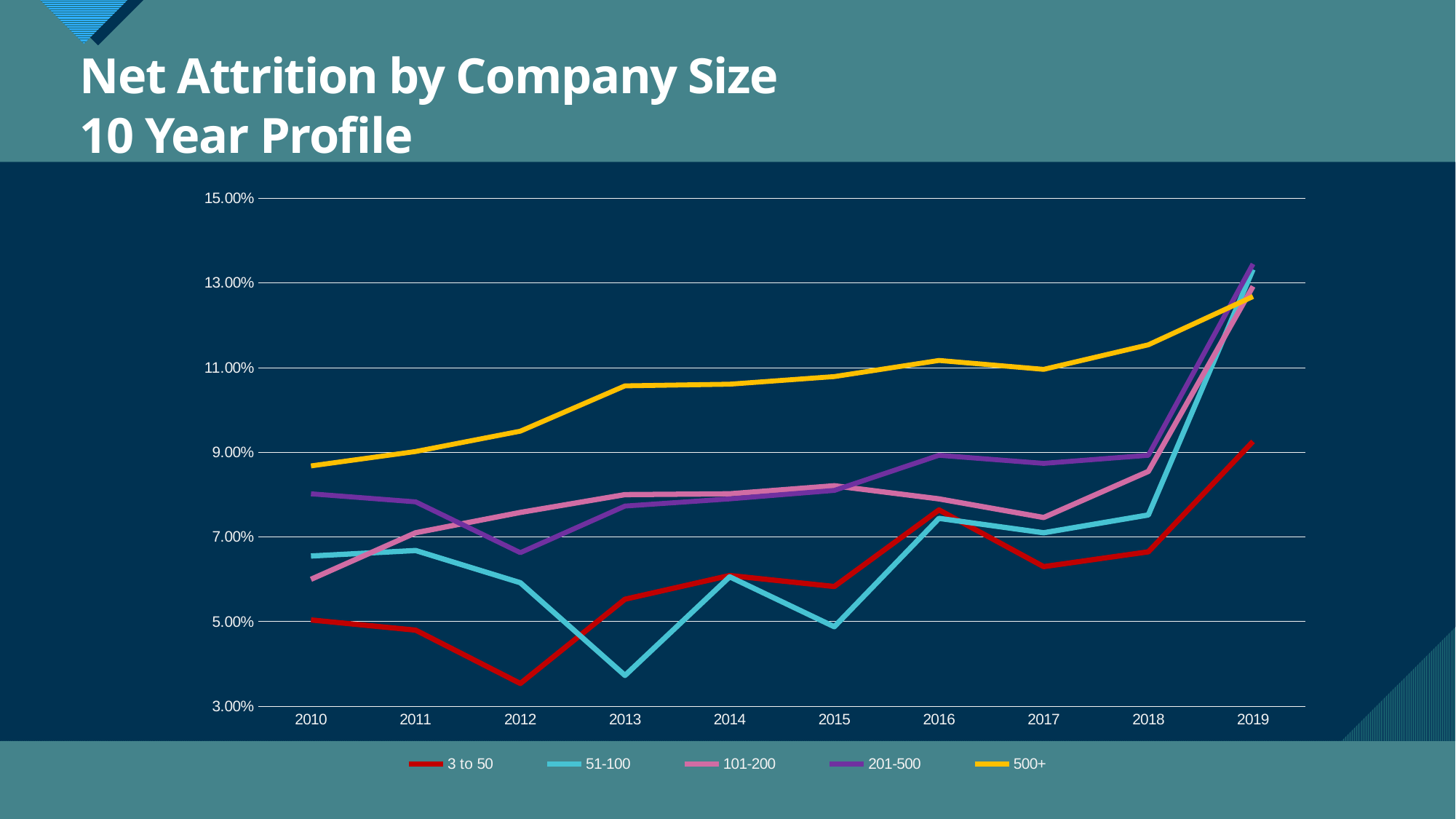
How many series does the legend list? 5 Is the value for 201-500 in 2019 greater or less than 13.00%? greater Is the value for 3 to 50 in 2012 greater or less than 5.00%? less Does the 500+ series generally rise or fall from 2010 to 2019? rise Which company size series has the lowest value in 2019? 3 to 50 Is the value for 500+ in 2010 greater or less than 9.00%? less Which company size series has the lowest value in 2013? 51-100 In 2012, which is larger: the value for 3 to 50 or the value for 51-100? 51-100 Which company size series has the lowest value in 2010? 3 to 50 What kind of chart is shown on the slide? line chart Which company size series has the highest value in 2010? 500+ How many years are shown along the x axis? 10